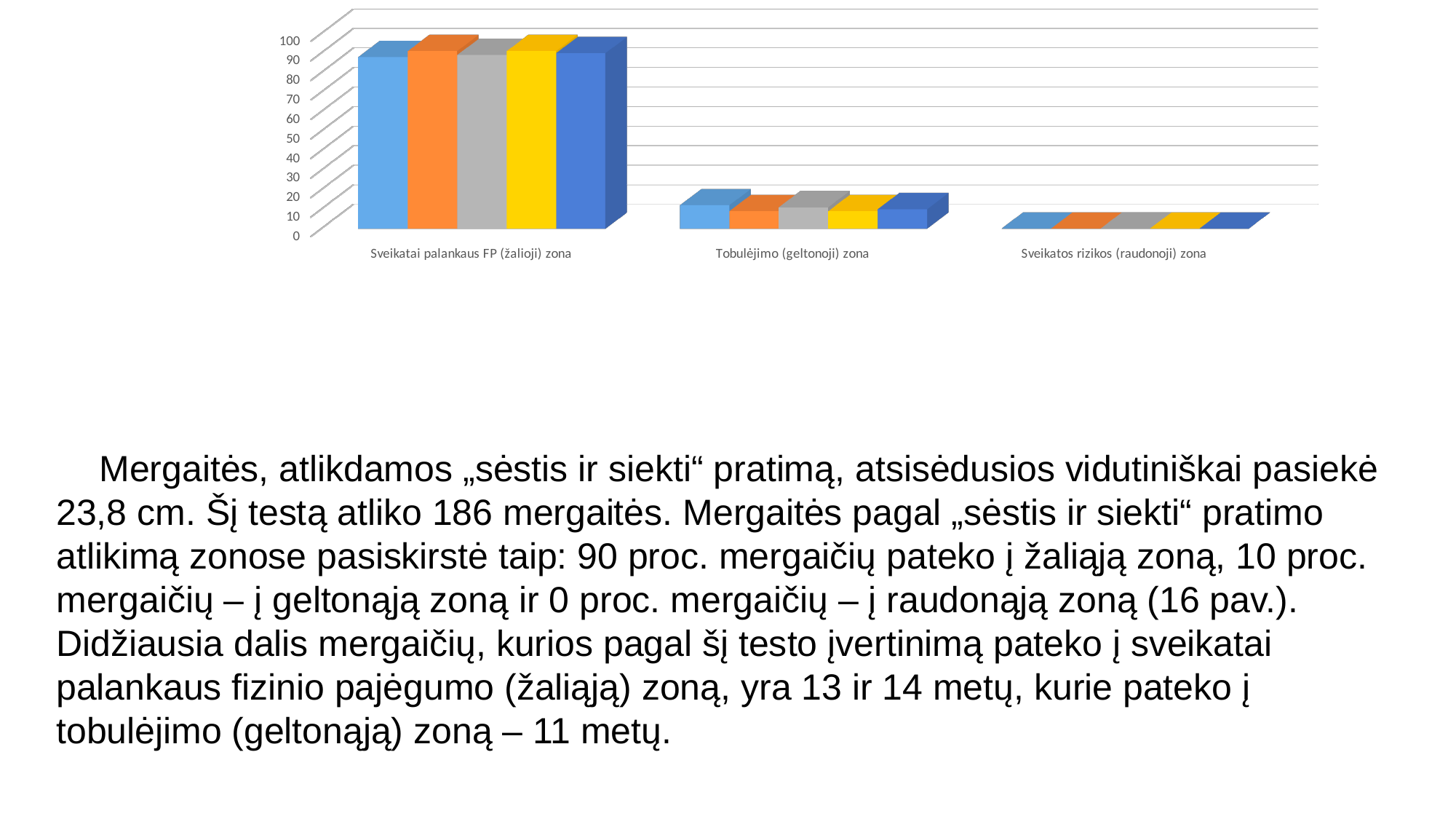
Are the values for Tobulėjimo (geltonoji) zona greater or less than 50? less What is the highest value shown on the vertical axis of the chart? 100 How many bars are drawn for each category in the chart? 5 Are the values for Sveikatai palankaus FP (žalioji) zona greater or less than 50? greater How many categories are shown on the x axis of the chart? 3 Do the values rise or fall moving from left to right along the x axis? fall Which category has the highest bars in the chart? Sveikatai palankaus FP (žalioji) zona Are the values for Sveikatos rizikos (raudonoji) zona greater or less than 10? less Which category has the lowest bars in the chart? Sveikatos rizikos (raudonoji) zona Which category has larger values: Tobulėjimo (geltonoji) zona or Sveikatos rizikos (raudonoji) zona? Tobulėjimo (geltonoji) zona Which category has larger values: Sveikatai palankaus FP (žalioji) zona or Tobulėjimo (geltonoji) zona? Sveikatai palankaus FP (žalioji) zona What kind of chart is shown on the slide? Bar chart